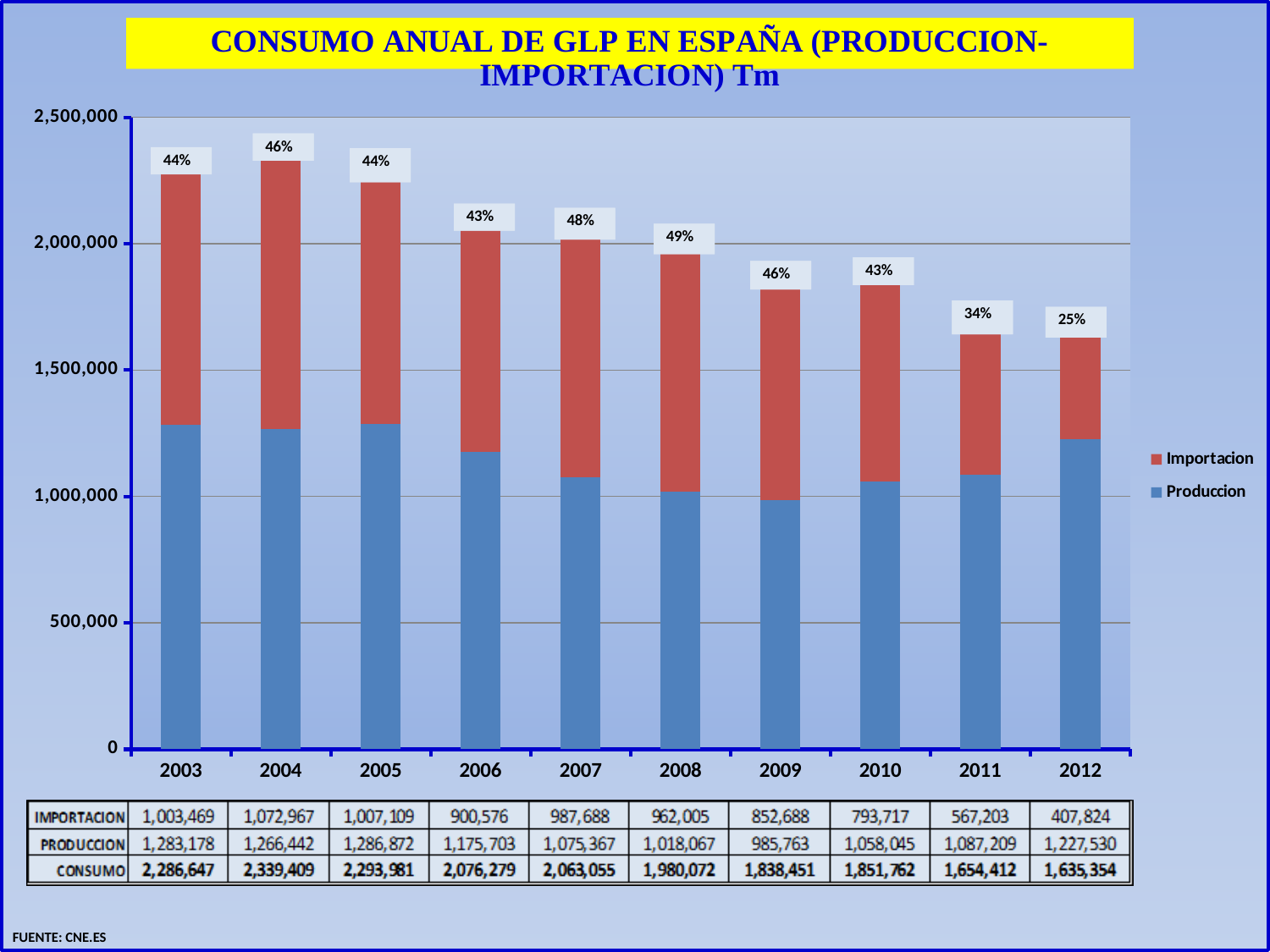
What is the Importacion value for 2012? 407,824 How many series does the legend list? 2 Which year has the highest total Consumo? 2004 What kind of chart is shown on the slide? Stacked bar chart Which year has the lowest Importacion value? 2012 How many years are shown on the x axis? 10 Which is larger in 2007, Importacion or Produccion? Produccion What percentage label is shown above the 2011 bar? 34% How much higher is the Consumo in 2004 than in 2012? 704,055 What is the total Consumo for 2009? 1,838,451 What is the difference between Produccion and Importacion in 2012? 819,706 What is the Produccion value for 2006? 1,175,703